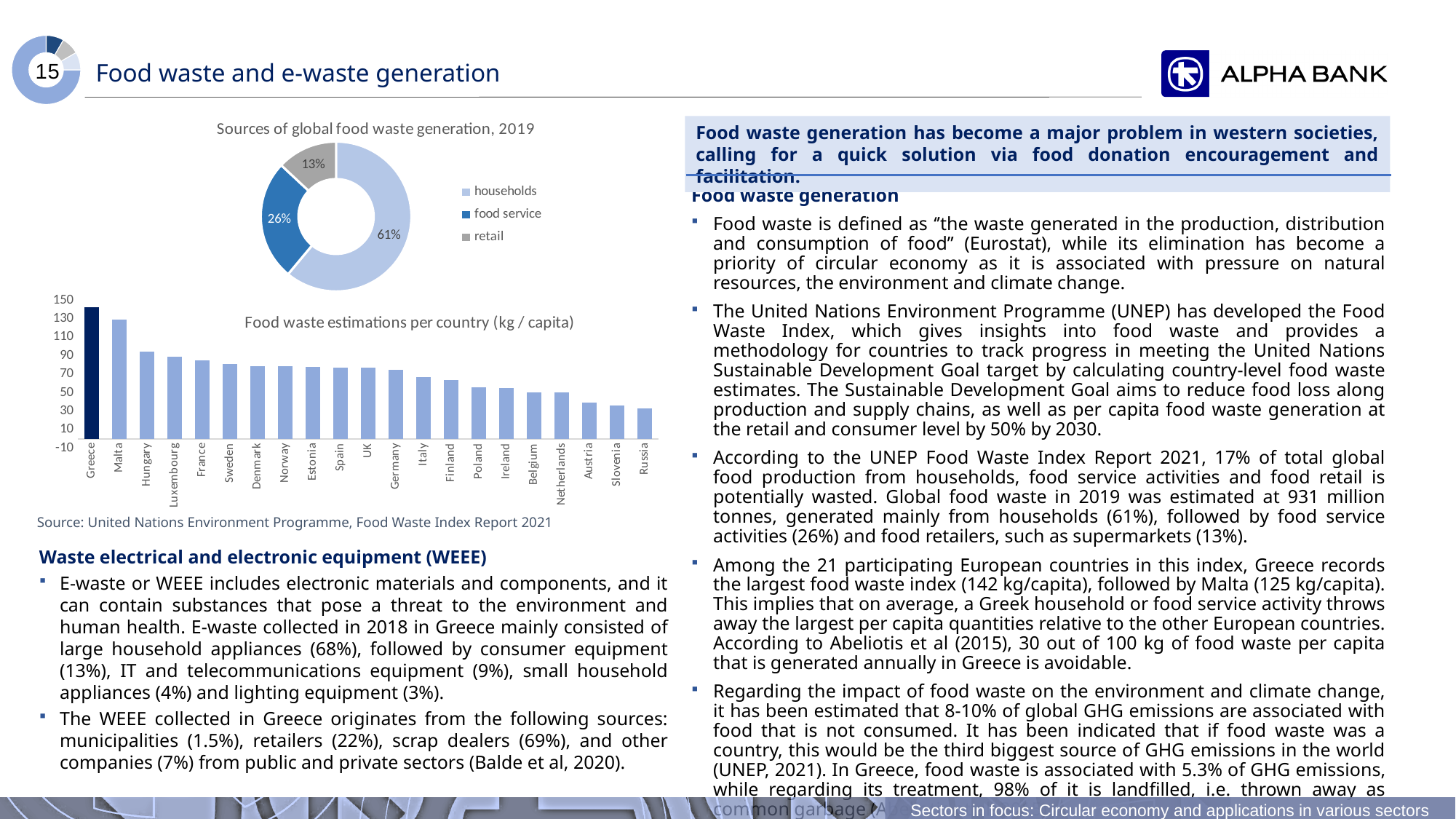
In the chart 'Food waste estimations per country (kg / capita)', is the value for Austria greater or less than 50? less In the chart 'Sources of global food waste generation, 2019', what share of global food waste comes from households? 61% How many entries does the legend of the chart 'Sources of global food waste generation, 2019' list? 3 In the chart 'Food waste estimations per country (kg / capita)', which country has the highest value? Greece What kind of chart is 'Sources of global food waste generation, 2019'? Doughnut (pie) chart In the chart 'Sources of global food waste generation, 2019', how many percentage points larger is the households share than the food service share? 35 percentage points In the chart 'Food waste estimations per country (kg / capita)', is the value for Greece greater or less than 130? greater In the chart 'Sources of global food waste generation, 2019', what share is attributed to food service? 26% What kind of chart is 'Food waste estimations per country (kg / capita)'? Bar chart How many countries are shown in the chart 'Food waste estimations per country (kg / capita)'? 21 In the chart 'Sources of global food waste generation, 2019', which source has the smallest share? retail In the chart 'Sources of global food waste generation, 2019', what share is attributed to retail? 13%